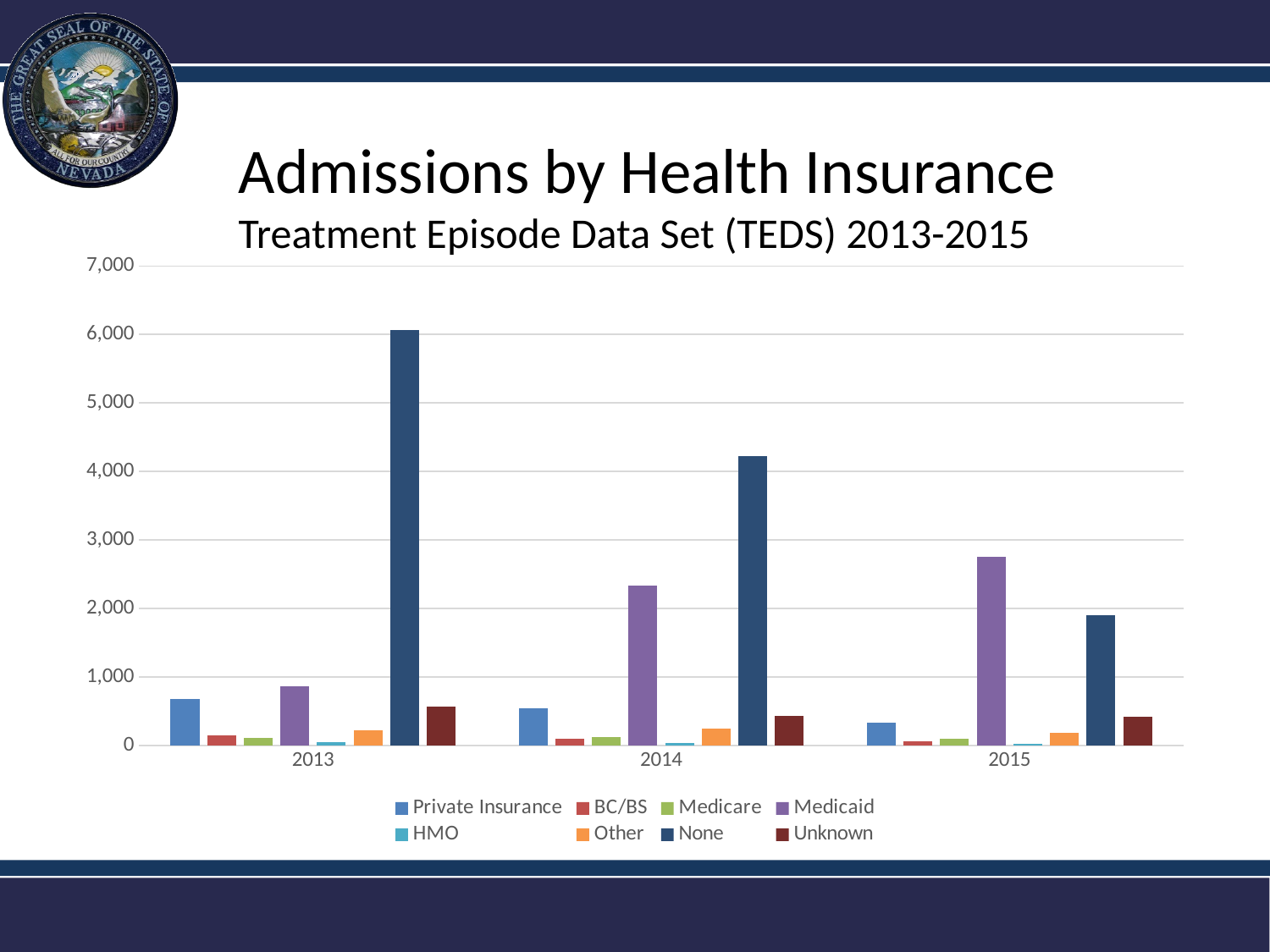
How many series does the legend list? 8 Which insurance category has the lowest admissions in 2013? HMO How many years are shown on the x axis? 3 What kind of chart is shown on the slide? Bar chart Is the value for None in 2013 greater or less than 5,000? greater Do the admissions for None rise or fall from 2013 to 2015? fall Do the admissions for Medicaid rise or fall from 2013 to 2015? rise In 2015, which is larger: Medicaid or None? Medicaid Is the value for Medicaid in 2014 greater or less than 2,000? greater Which insurance category has the highest admissions in 2013? None In 2014, which is larger: Medicaid or None? None